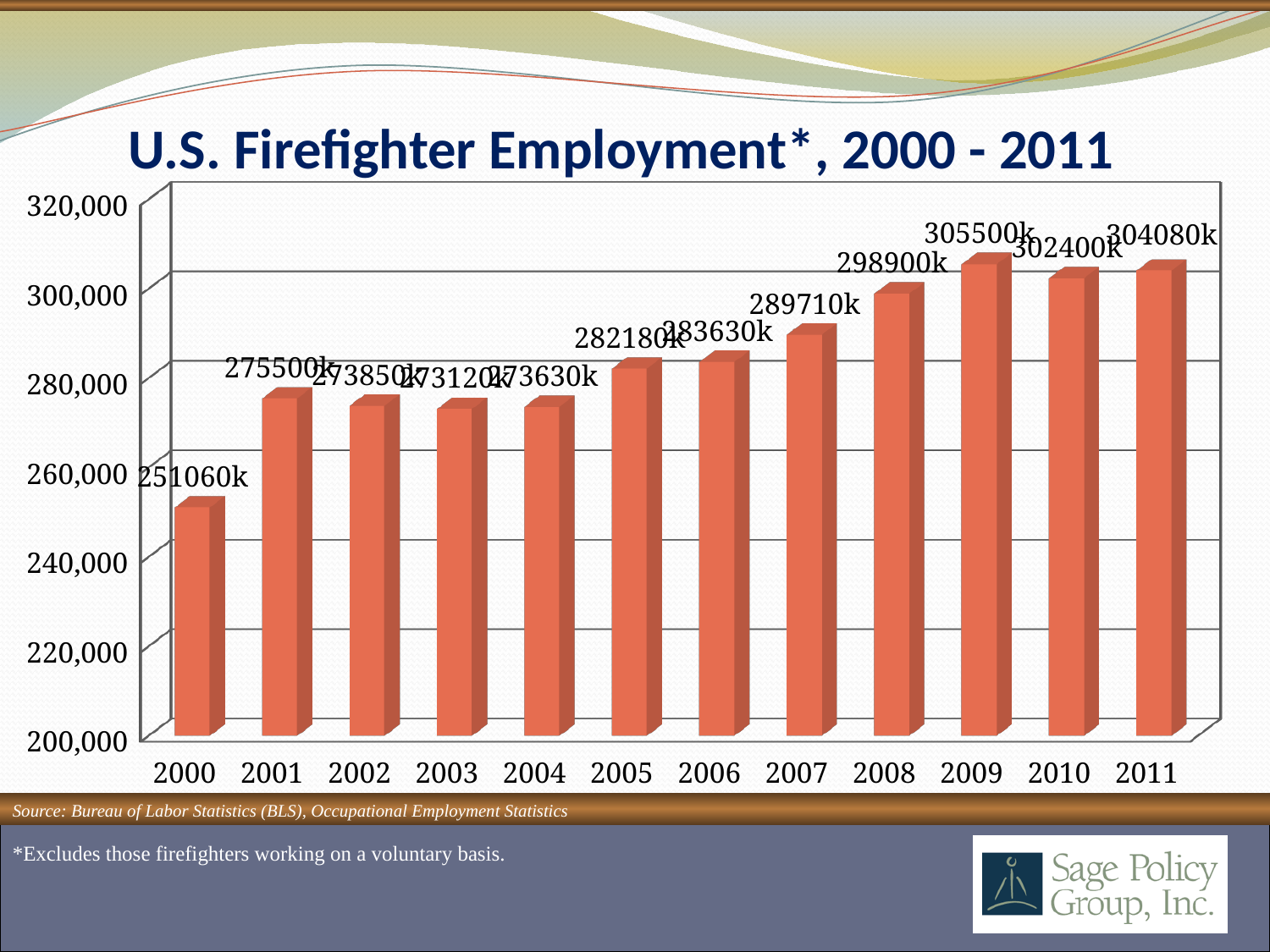
Is the value for 2003 greater or less than 280,000? less What is the value for 2000? 251060k Which is larger, the value for 2008 or the value for 2007? 2008 What is the value for 2011? 304080k What is the value for 2009? 305500k What is the title of the chart? U.S. Firefighter Employment*, 2000 - 2011 How many years are shown on the x axis? 12 What kind of chart is shown on the slide? bar chart Do the values rise or fall from 2005 to 2009? rise What is the difference between the values for 2009 and 2000? 54440k Which year has the highest firefighter employment? 2009 Which year has the lowest firefighter employment? 2000